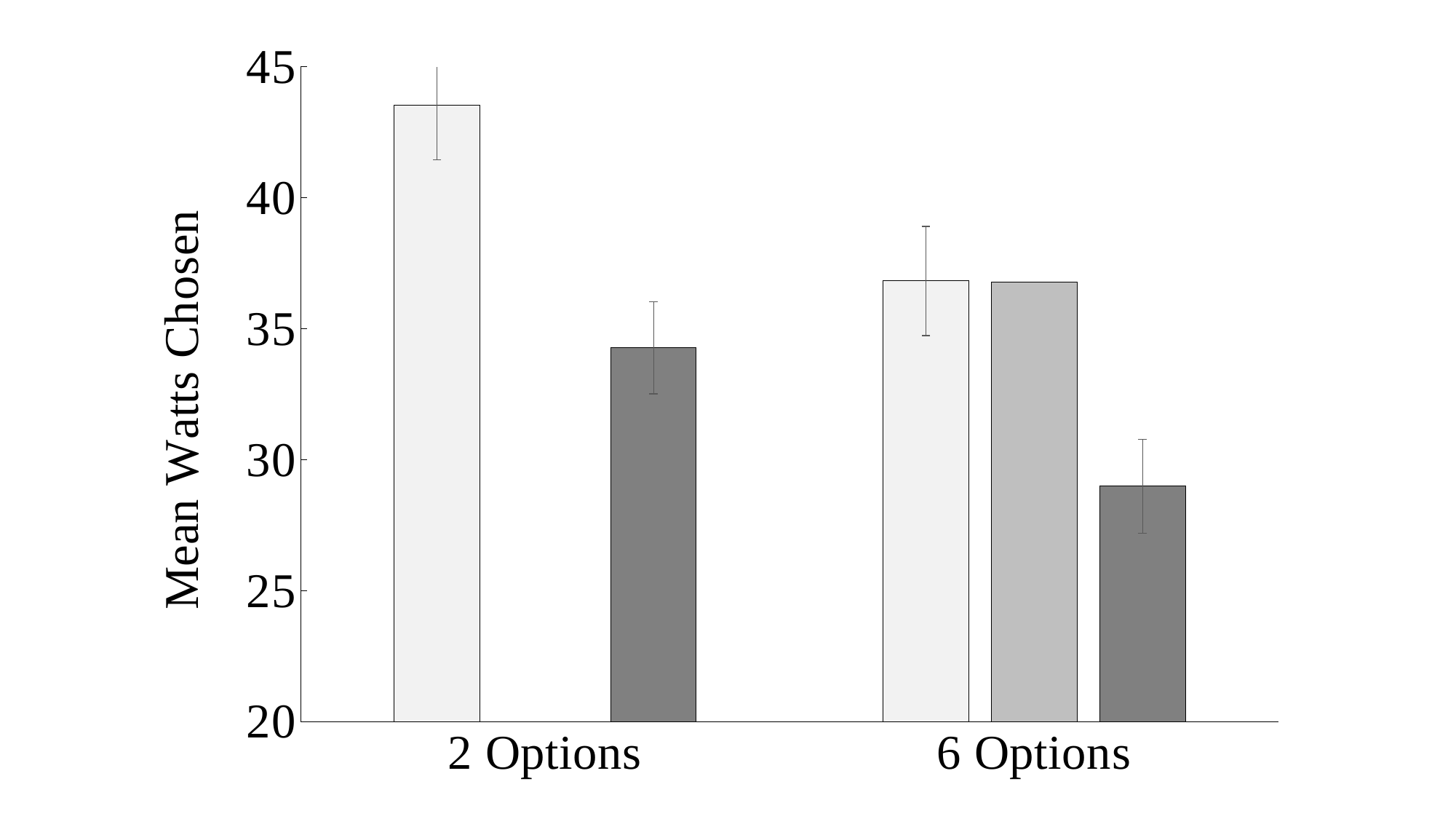
Which is larger: the lightest bar in the 2 Options group or the lightest bar in the 6 Options group? the lightest bar in the 2 Options group Is the value of the darkest bar in the 6 Options group greater or less than 35? less How many category groups are labelled on the x axis? 2 Which bar is the tallest on the chart? the lightest bar in the 2 Options group How many bars are plotted in total across both groups? 5 Is the value of the lightest bar in the 2 Options group greater or less than 40? greater Which bar is the shortest on the chart? the darkest bar in the 6 Options group How many bars are in the 6 Options group? 3 Is the value of the darkest bar in the 2 Options group greater or less than 30? greater What kind of chart is shown on the slide? bar chart What is the title of the y axis? Mean Watts Chosen